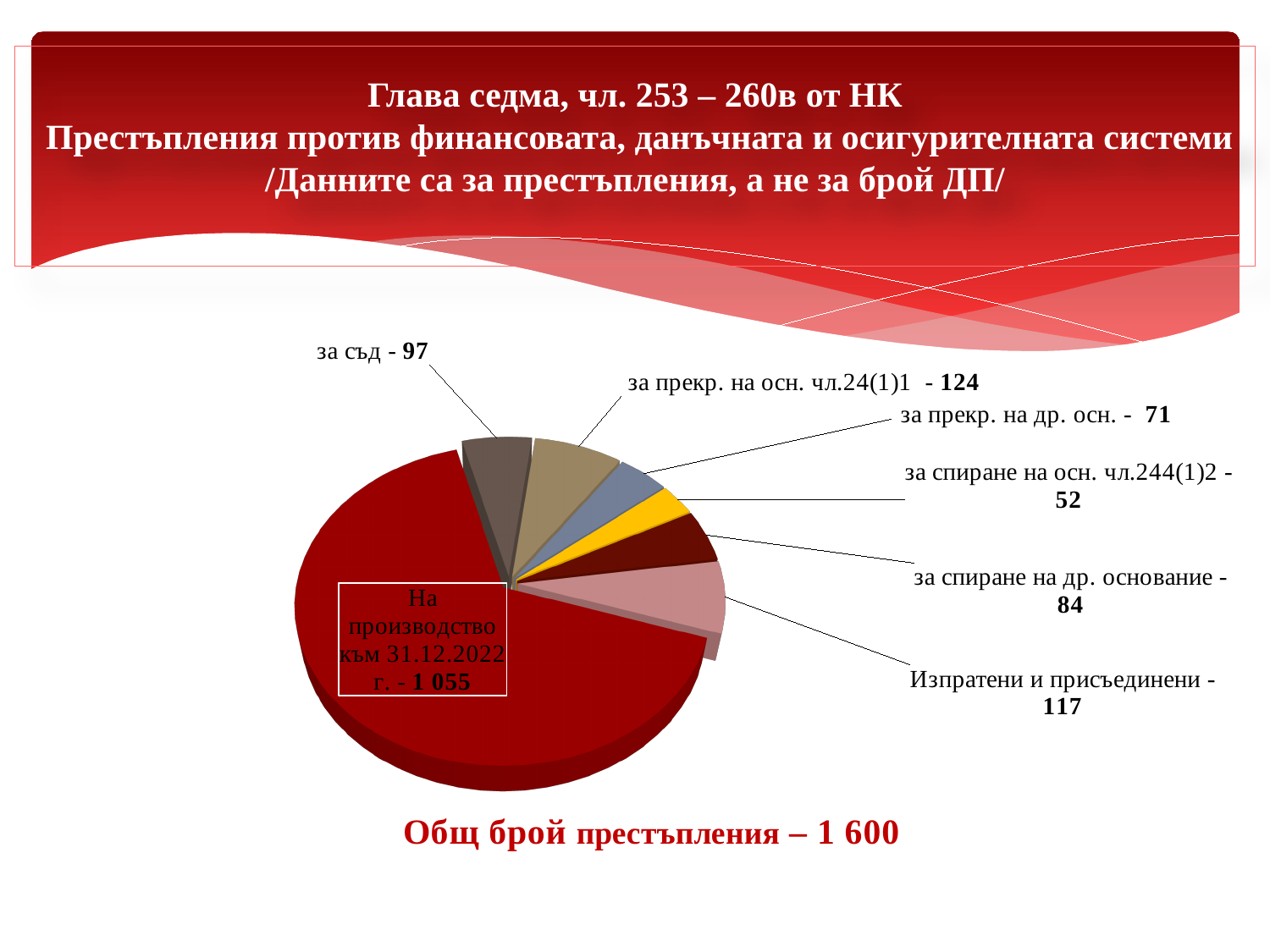
What total number of crimes is stated below the pie chart? 1 600 What is the difference between the values for "за прекр. на осн. чл.24(1)1" and "за прекр. на др. осн."? 53 What is the value for "за спиране на осн. чл.244(1)2"? 52 What kind of chart is shown on the slide? pie chart Which category has the largest slice of the pie? На производство към 31.12.2022 г. How many slices does the pie chart have? 7 What is the value for "за съд"? 97 What is the value for "за прекр. на осн. чл.24(1)1"? 124 What is the value for "Изпратени и присъединени"? 117 What is the value for "На производство към 31.12.2022 г."? 1 055 Which is larger, the value for "Изпратени и присъединени" or the value for "за спиране на др. основание"? Изпратени и присъединени Which category has the smallest slice of the pie? за спиране на осн. чл.244(1)2